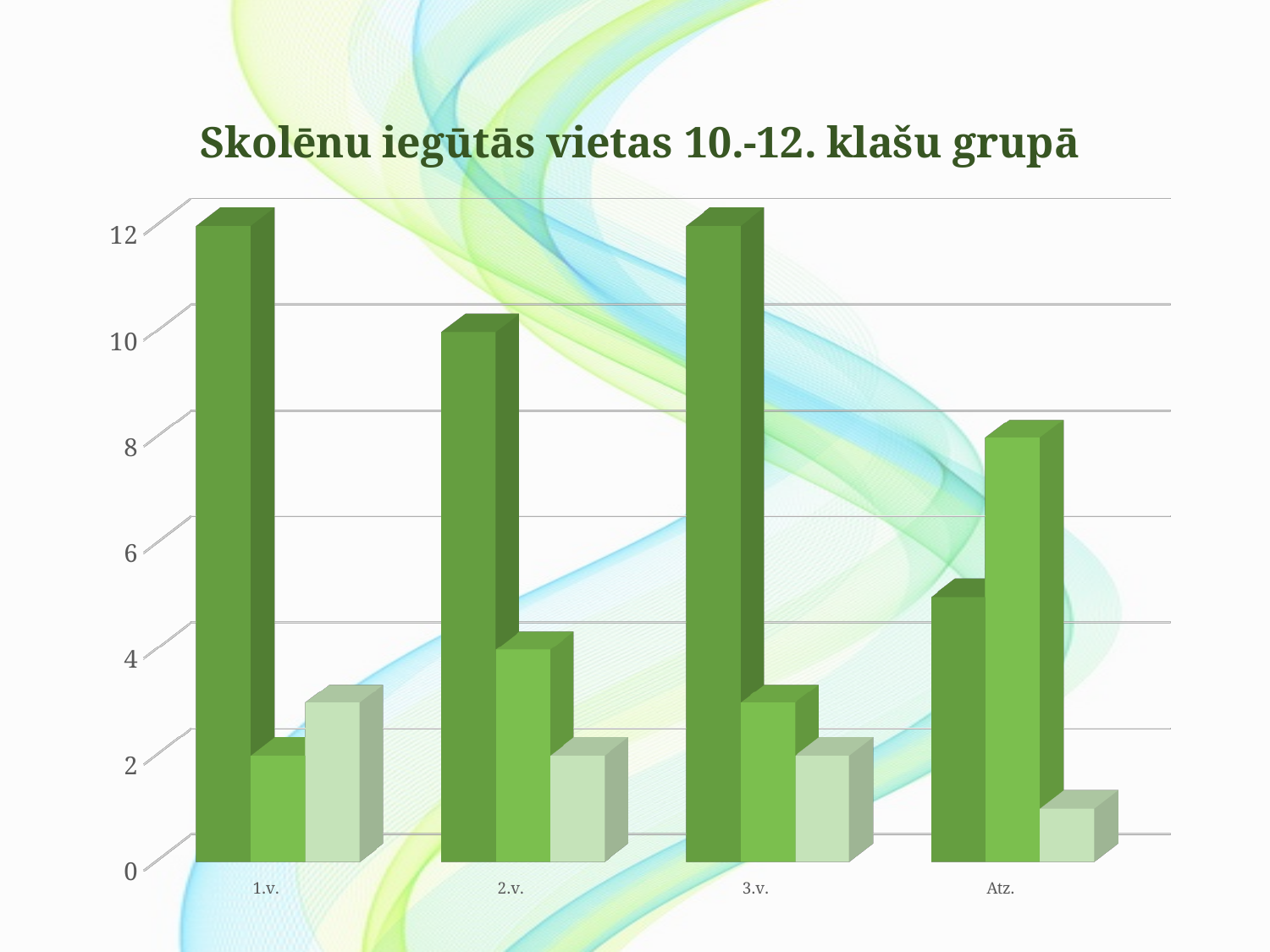
What is the title of the chart? Skolēnu iegūtās vietas 10.-12. klašu grupā How many bars are shown for each category in the chart? 3 Is the value of the darkest green bar for 1.v. greater or less than 10? greater For Atz., which is larger: the darkest green bar or the medium green bar? the medium green bar How many categories are shown on the x axis of the chart? 4 Which category has the lowest value for the darkest green bar? Atz. Is the value of the darkest green bar for Atz. greater or less than 6? less Is the value of the darkest green bar for 2.v. greater or less than 8? greater Which category has the highest value for the middle (medium green) bar? Atz. What kind of chart is shown on the slide? bar chart